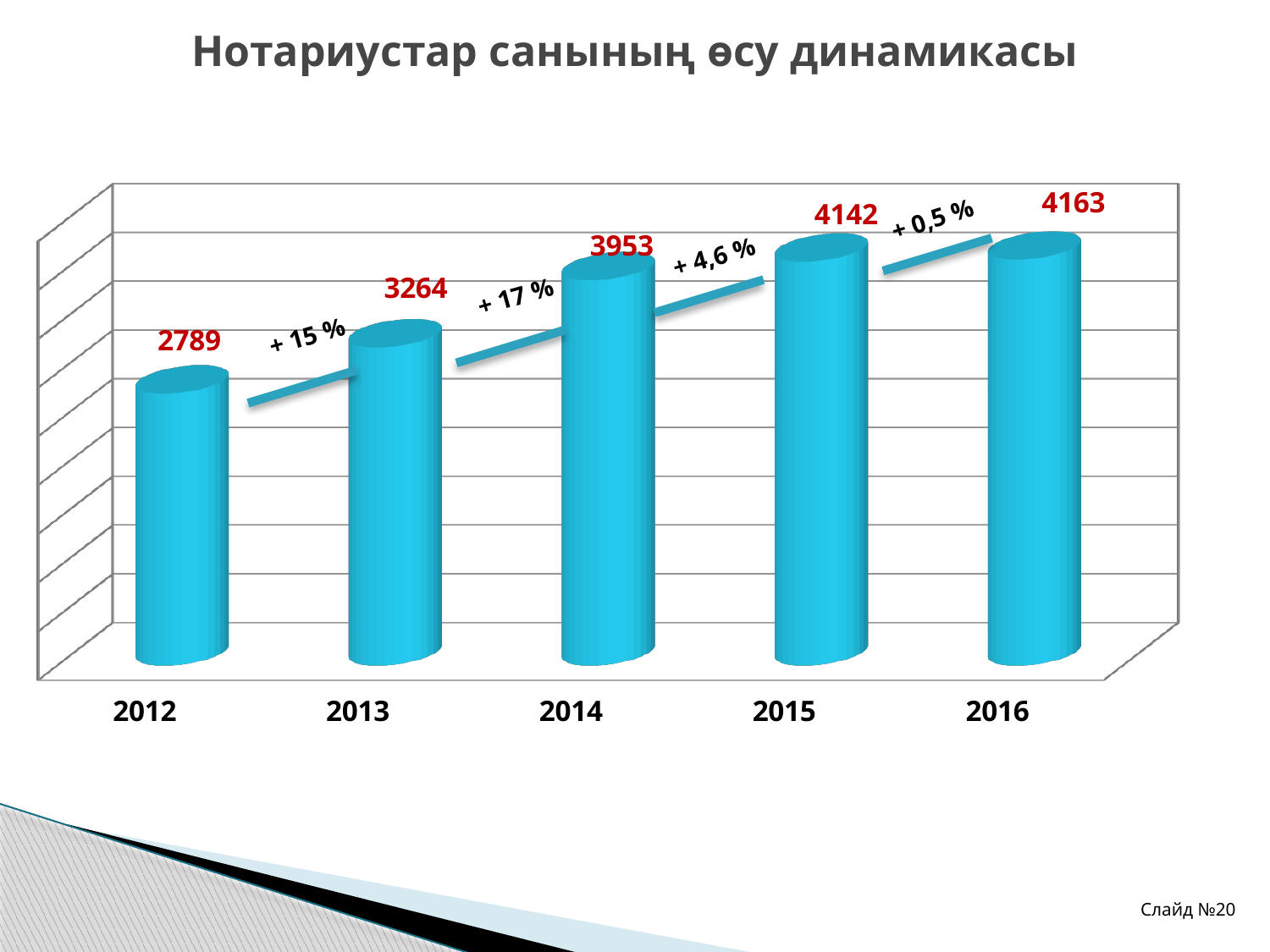
What is the value for 2012? 2789 What is the value for 2016? 4163 What is the difference between the values for 2013 and 2012? 475 Which is larger, the value for 2014 or the value for 2013? 2014 What kind of chart is this? bar chart What is the value for 2014? 3953 How many years are shown on the x axis? 5 Which year has the highest value? 2016 What is the difference between the values for 2016 and 2015? 21 Do the values rise or fall from 2012 to 2016? rise What percentage growth is labelled between 2013 and 2014? + 17 % Which year has the lowest value? 2012